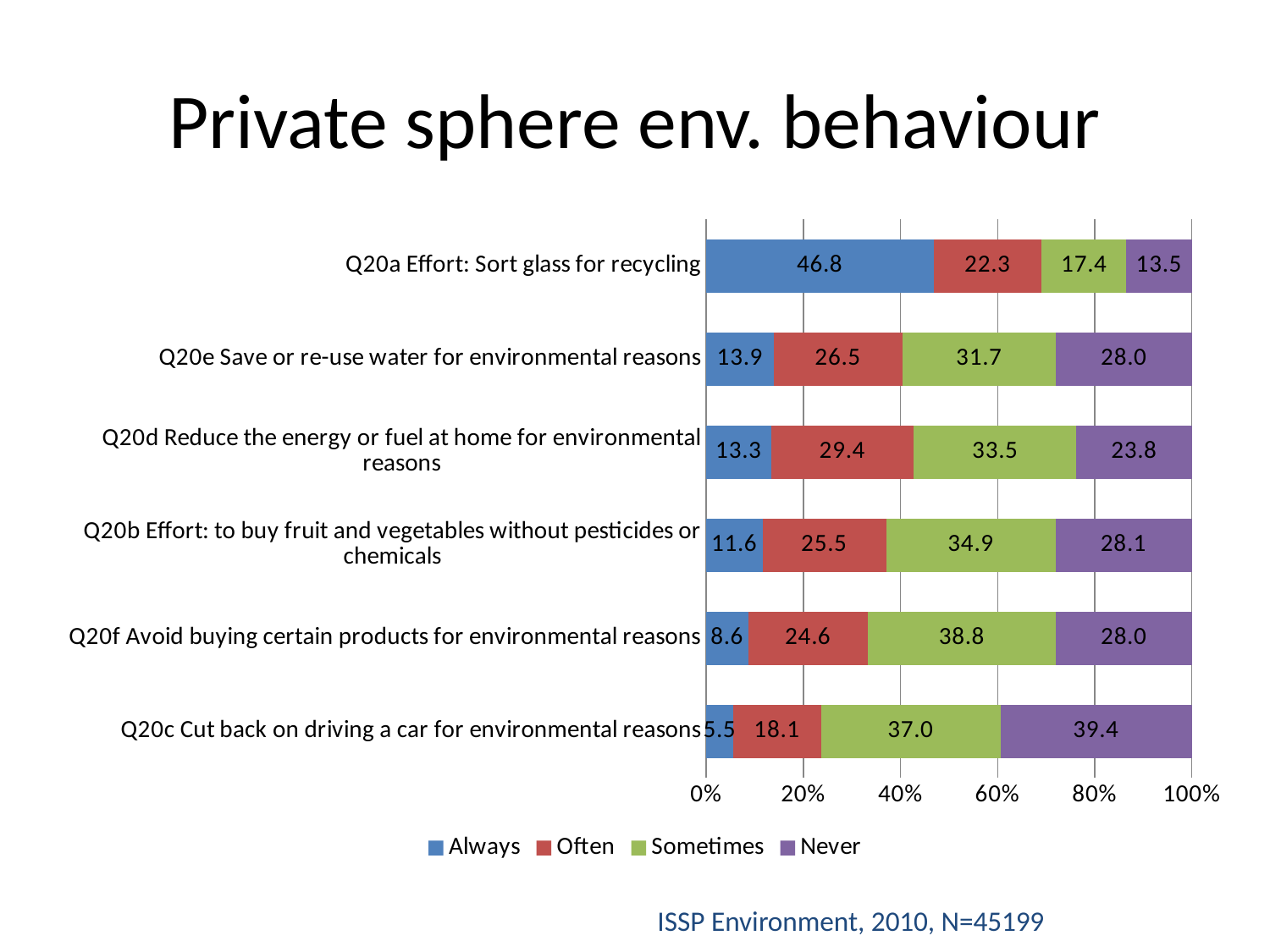
Which category has the highest 'Always' value? Q20a Effort: Sort glass for recycling Which is larger: the 'Sometimes' value for 'Q20e Save or re-use water for environmental reasons' or for 'Q20b Effort: to buy fruit and vegetables without pesticides or chemicals'? Q20b Effort: to buy fruit and vegetables without pesticides or chemicals What is the 'Often' value for 'Q20d Reduce the energy or fuel at home for environmental reasons'? 29.4 What kind of chart is shown on the slide? Stacked bar chart How many series does the legend list? 4 What colour represents the 'Never' series in the chart? Purple What is the 'Sometimes' value for 'Q20f Avoid buying certain products for environmental reasons'? 38.8 How many categories are shown on the chart? 6 What is the 'Always' value for 'Q20a Effort: Sort glass for recycling'? 46.8 Which category has the lowest 'Always' value? Q20c Cut back on driving a car for environmental reasons What is the 'Never' value for 'Q20c Cut back on driving a car for environmental reasons'? 39.4 What is the difference between the 'Never' values for 'Q20c Cut back on driving a car for environmental reasons' and 'Q20a Effort: Sort glass for recycling'? 25.9